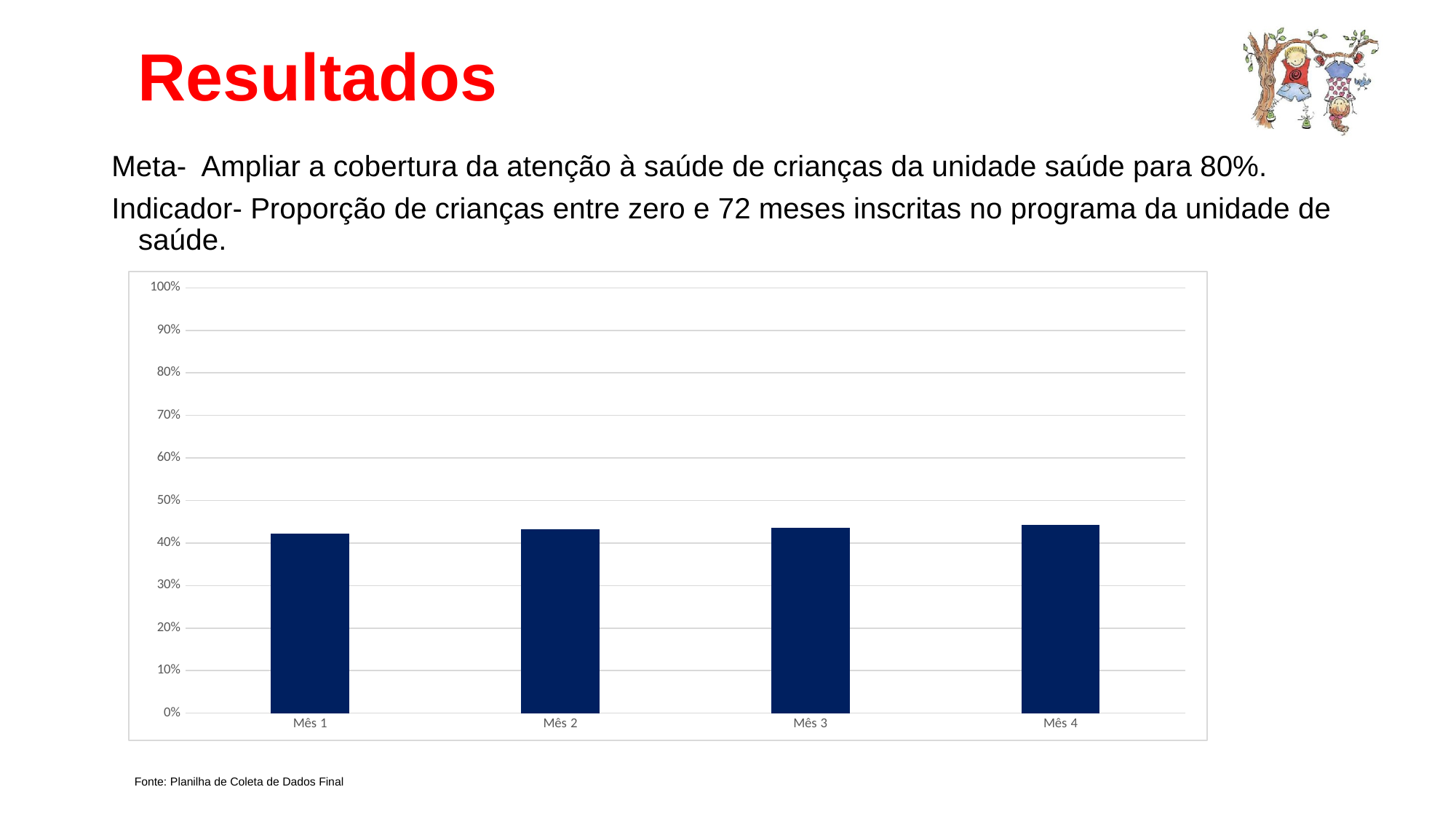
What source is cited below the chart? Planilha de Coleta de Dados Final Is the value for Mês 1 greater or less than 50%? less Is the value for Mês 4 greater or less than 50%? less Which is larger, the value for Mês 1 or the value for Mês 4? Mês 4 Is the value for Mês 4 greater or less than 80%? less What kind of chart is shown on the slide? bar chart What is the highest value shown on the y axis of the chart? 100% How many categories (months) are shown on the x axis of the chart? 4 Do the values rise or fall from Mês 1 to Mês 4? rise